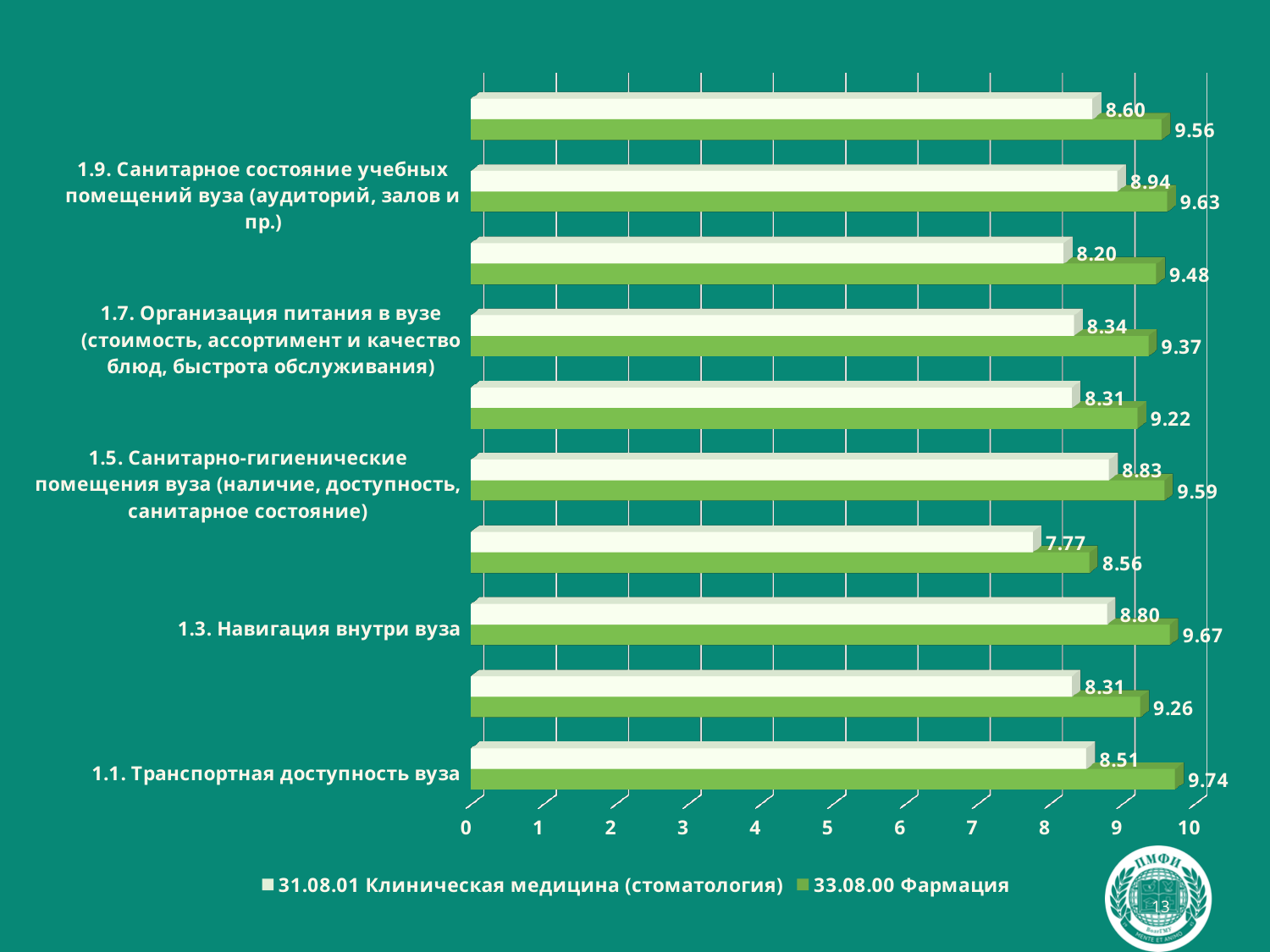
How many series does the legend list? 2 For 1.1. Транспортная доступность вуза, which series has the larger value: 31.08.01 Клиническая медицина (стоматология) or 33.08.00 Фармация? 33.08.00 Фармация What is the value for 33.08.00 Фармация for category 1.1. Транспортная доступность вуза? 9.74 What is the difference between the 33.08.00 Фармация and 31.08.01 Клиническая медицина (стоматология) values for 1.5. Санитарно-гигиенические помещения вуза? 0.76 Is the value for 31.08.01 Клиническая медицина (стоматология) for 1.7. Организация питания в вузе greater or less than 9? less What is the value for 31.08.01 Клиническая медицина (стоматология) for category 1.9. Санитарное состояние учебных помещений вуза? 8.94 How many category groups of bars are plotted on the chart? 10 Which series is shown in green in the legend? 33.08.00 Фармация What is the value for 33.08.00 Фармация for category 1.7. Организация питания в вузе? 9.37 Which category has the highest value for 33.08.00 Фармация? 1.1. Транспортная доступность вуза What is the value for 31.08.01 Клиническая медицина (стоматология) for category 1.3. Навигация внутри вуза? 8.80 What kind of chart is shown on the slide? bar chart